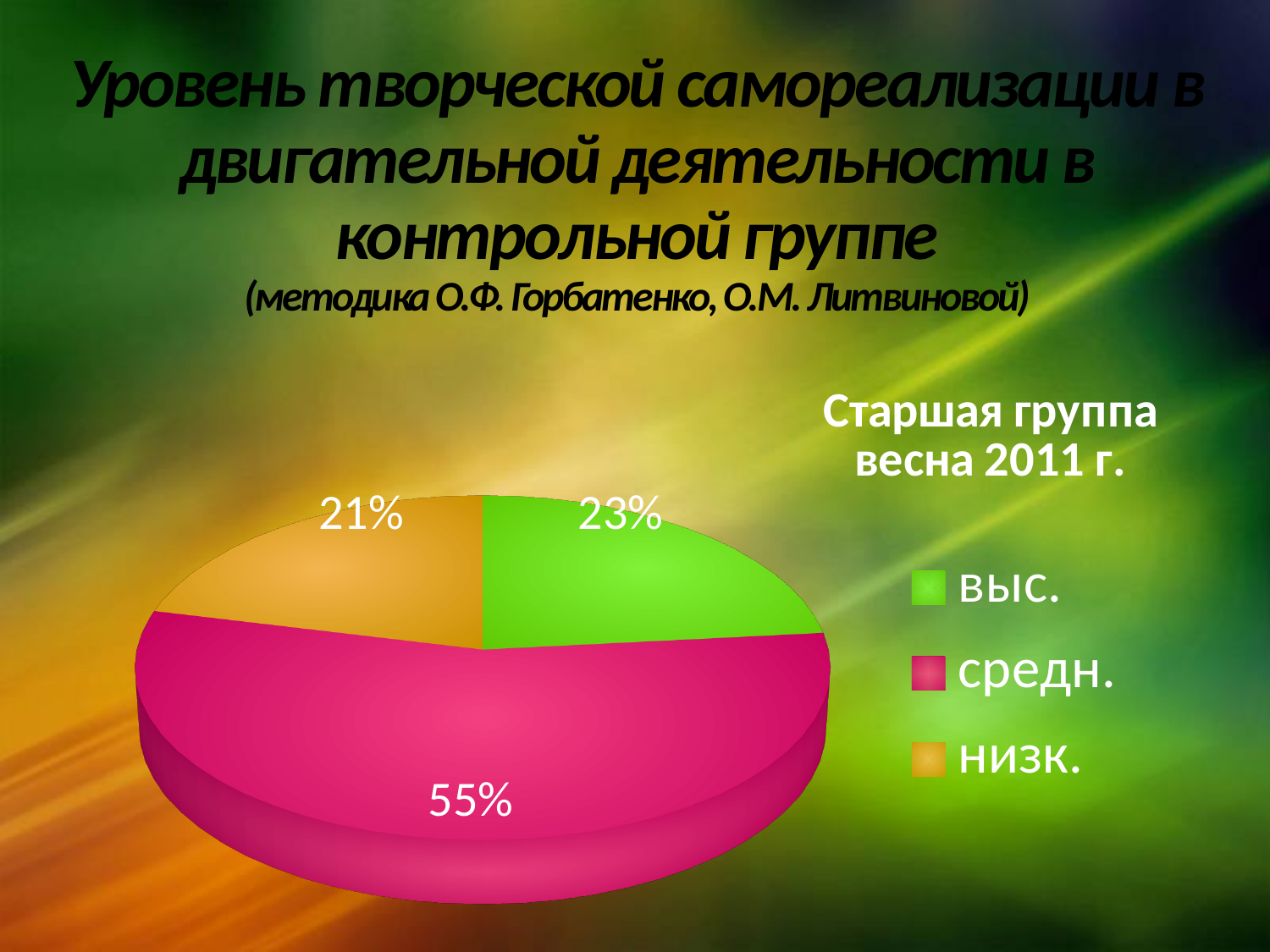
What is the difference between the 'средн.' and 'выс.' values? 32% What is the value for the 'средн.' slice? 55% What is the difference between the 'выс.' and 'низк.' values? 2% Which category has the smallest share of the pie? низк. How many slices does the pie chart have? 3 What is the value for the 'выс.' slice? 23% What is the title of the chart? Старшая группа весна 2011 г. Which is larger, the 'средн.' slice or the 'низк.' slice? средн. Which category has the largest share of the pie? средн. How many entries does the legend list? 3 What kind of chart is shown on the slide? pie chart What is the value for the 'низк.' slice? 21%